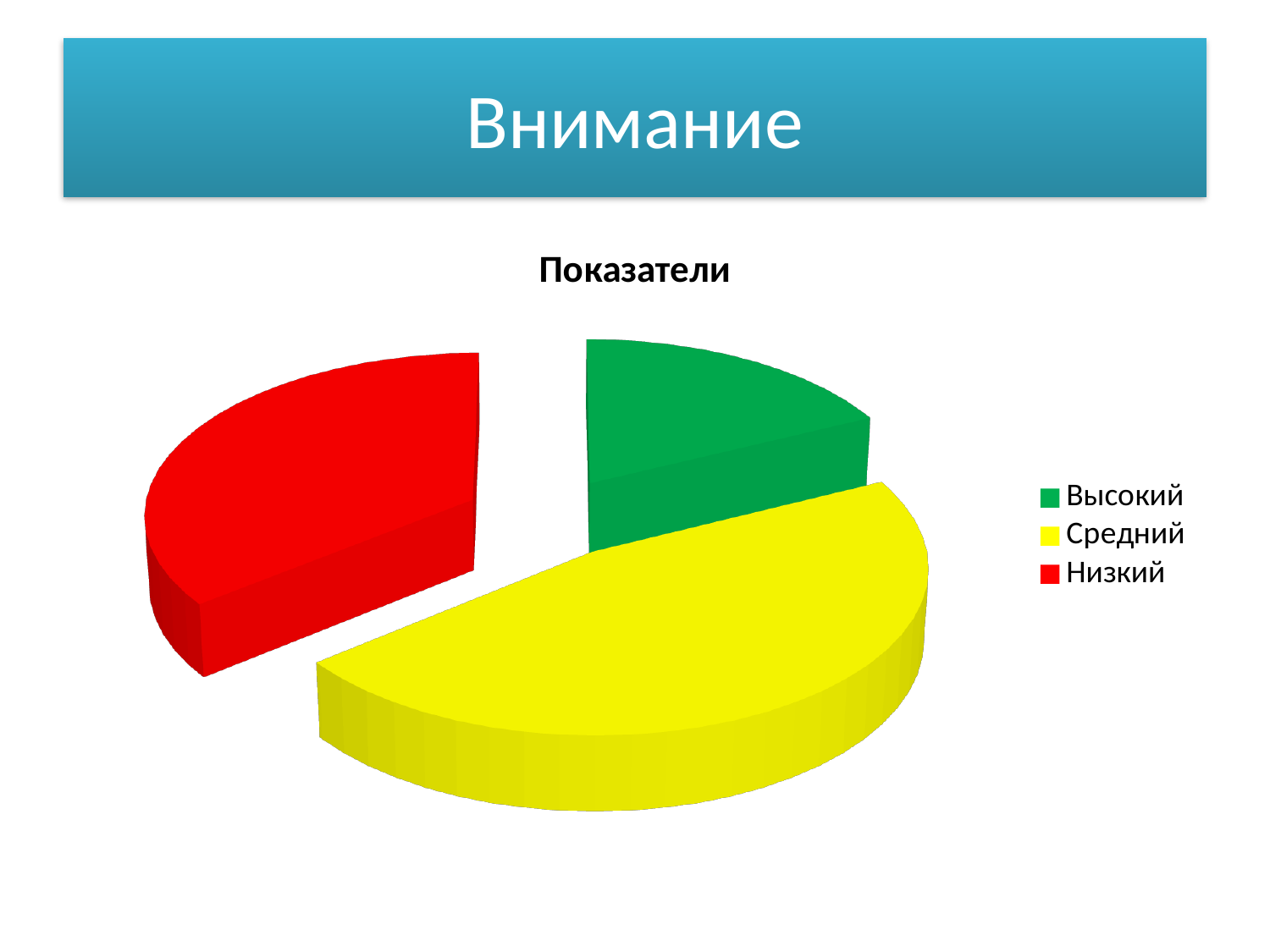
Which slice is larger, Средний or Высокий? Средний What colour is the slice for Низкий? red Which slice is larger, Низкий or Высокий? Низкий What kind of chart is shown on the slide? pie chart What is the title of the chart? Показатели How many entries does the legend list? 3 How many slices does the pie chart have? 3 Which category has the smallest slice of the pie? Высокий Which category has the largest slice of the pie? Средний